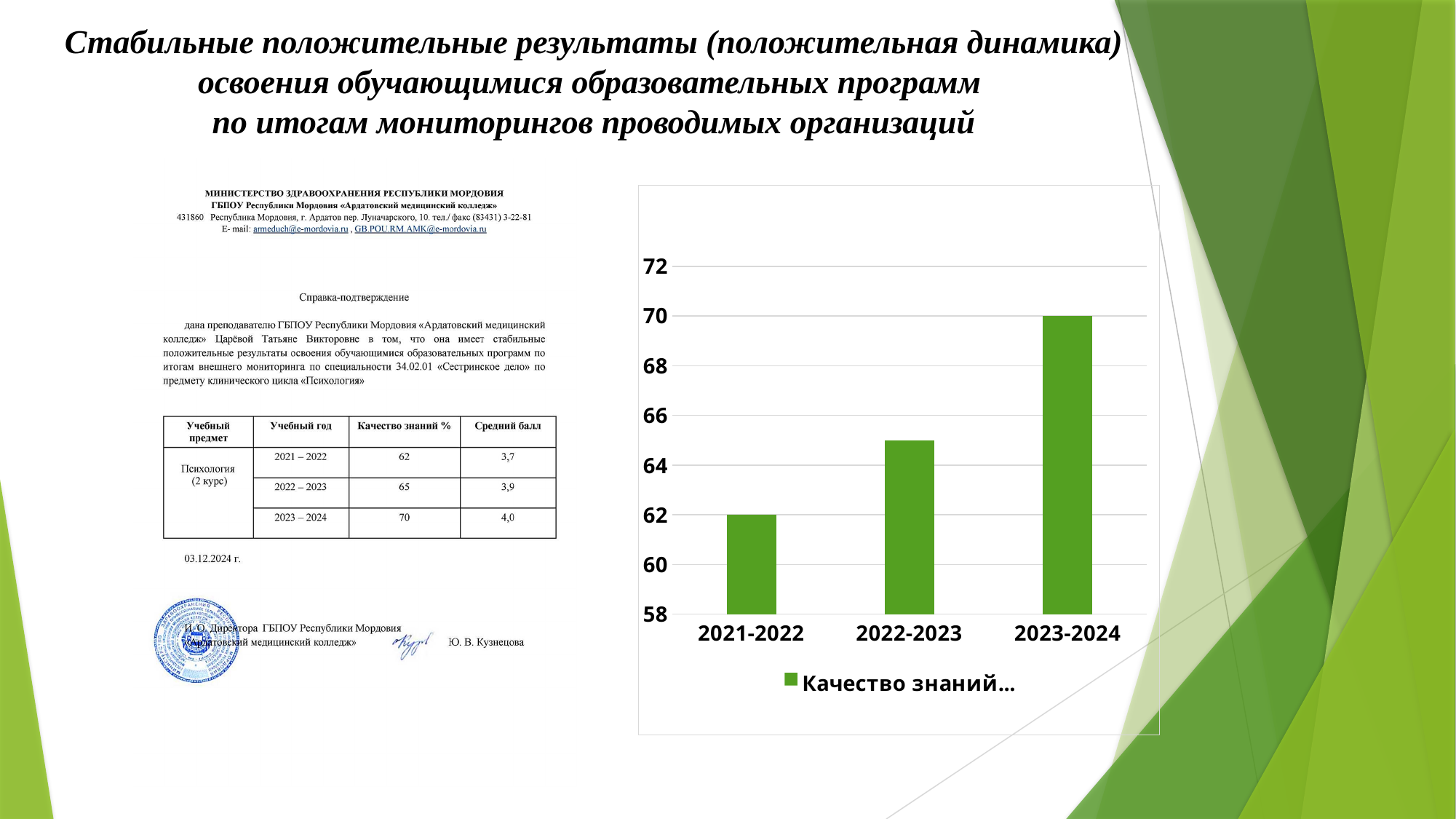
Is the value for 2022-2023 greater or less than 66? less Which academic year has the highest value in the chart? 2023-2024 What is the value for 2021-2022 in the chart? 62 Which academic year has the lowest value in the chart? 2021-2022 Is the value for 2022-2023 greater or less than 64? greater How many categories (academic years) are shown on the x axis of the chart? 3 What is the value for 2023-2024 in the chart? 70 What kind of chart is shown on the slide? bar chart Which is larger, the value for 2022-2023 or the value for 2023-2024? 2023-2024 Do the values rise or fall from 2021-2022 to 2023-2024? rise What is the difference between the values for 2023-2024 and 2021-2022? 8 How many series does the chart legend list? 1